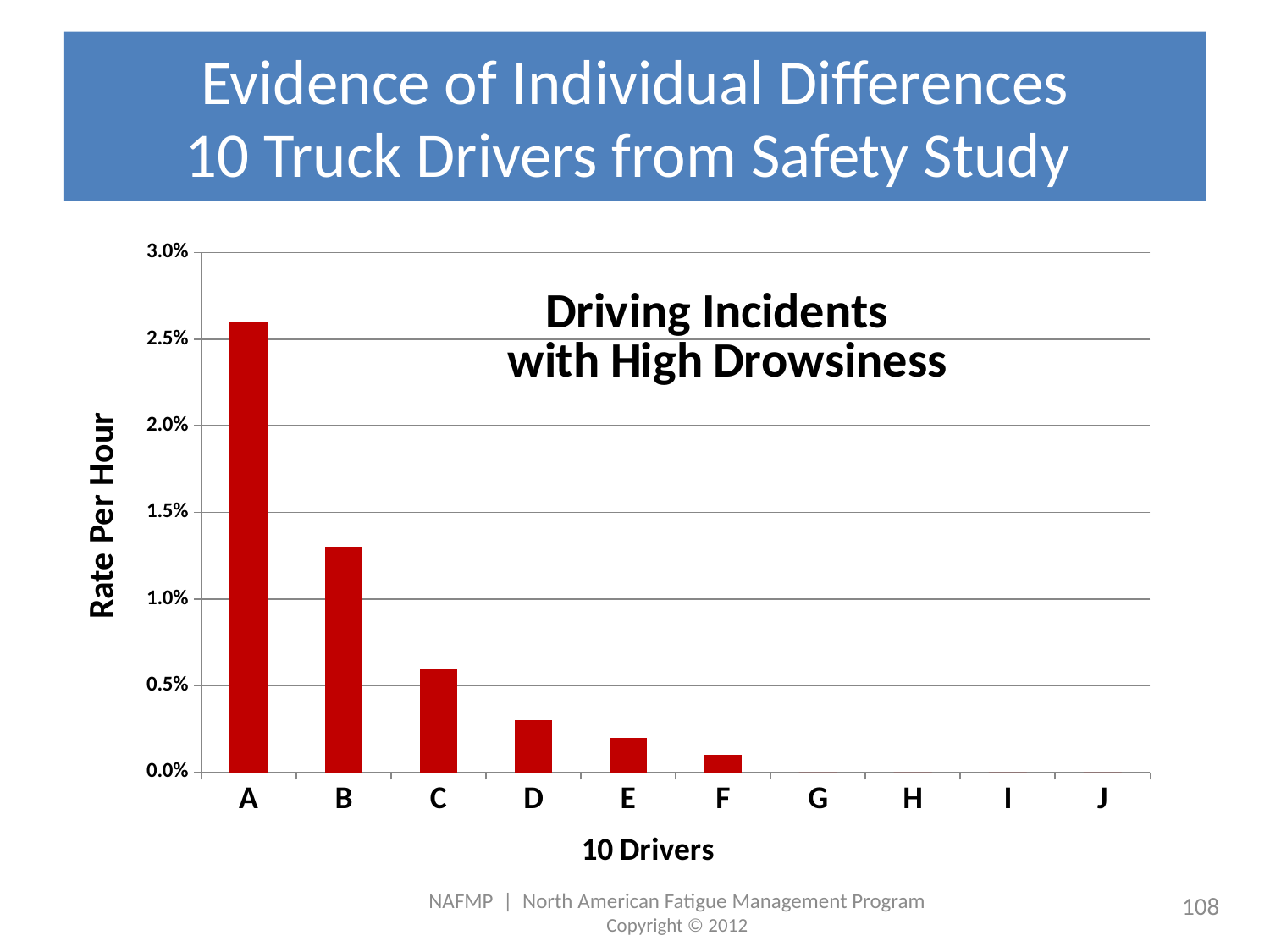
Is the rate per hour for driver D greater or less than 0.5%? less What is the title of the chart? Driving Incidents with High Drowsiness How many drivers are shown on the x axis of the chart? 10 What is the label on the y axis of the chart? Rate Per Hour Which driver has a higher rate per hour, A or B? A Do the rates per hour rise or fall moving from driver A to driver J along the x axis? Fall Is the rate per hour for driver B greater or less than 1.0%? greater Is the rate per hour for driver A greater or less than 2.0%? greater Which driver has a higher rate per hour, C or D? C Which driver has the highest rate per hour of driving incidents with high drowsiness? A What kind of chart is shown on the slide? Bar chart